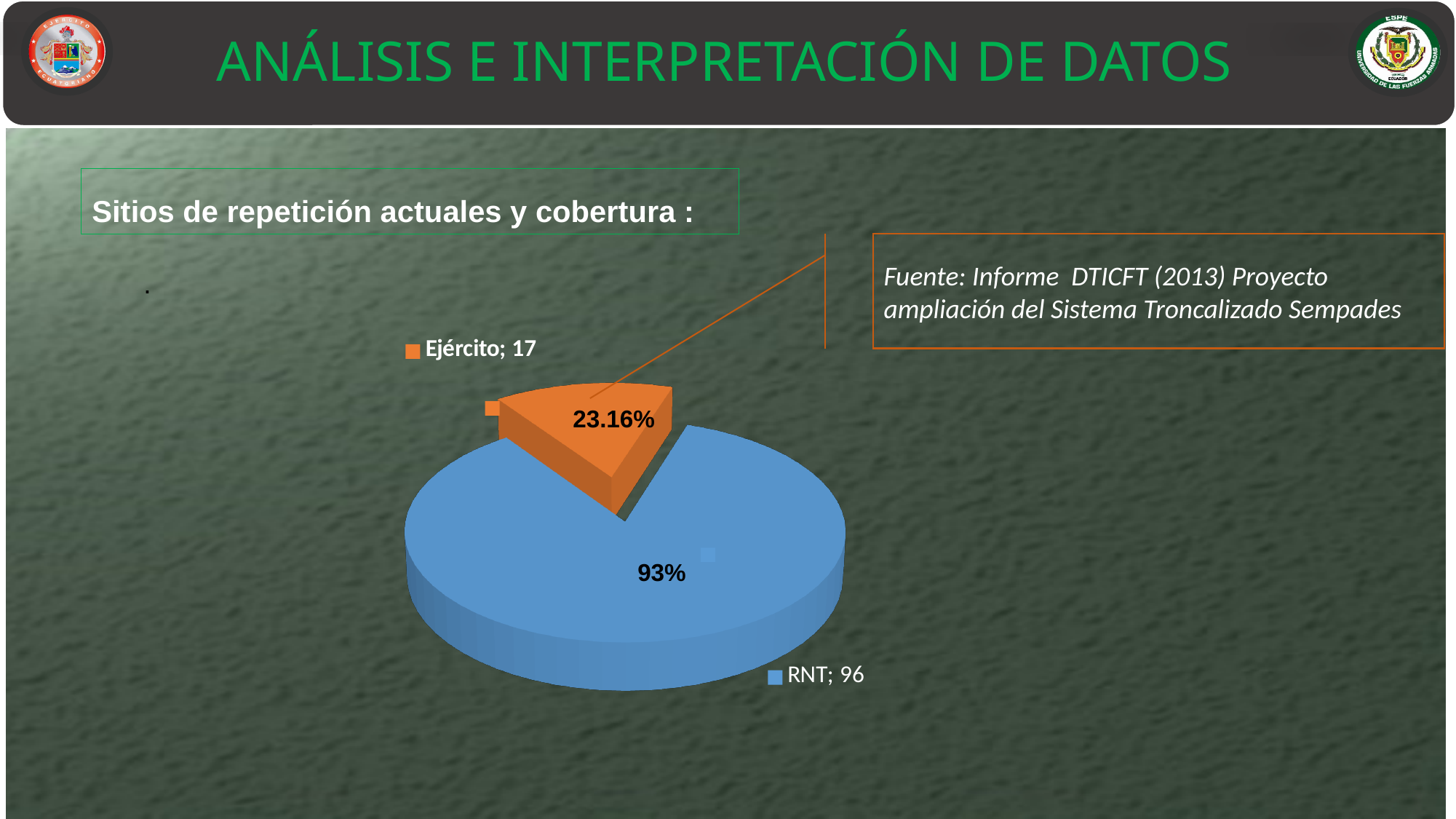
What kind of chart is shown on the slide? pie chart What is the value for RNT in the pie chart? 96 What percentage label is printed on the RNT slice? 93% What colour is the Ejército slice in the pie chart? orange How many slices does the pie chart have? 2 What is the value for Ejército in the pie chart? 17 Which category has the largest slice in the pie chart? RNT What percentage label is printed on the Ejército slice? 23.16% What is the difference between the values for RNT and Ejército? 79 What colour is the RNT slice in the pie chart? blue Which is larger, the value for RNT or the value for Ejército? RNT Which category has the smallest slice in the pie chart? Ejército